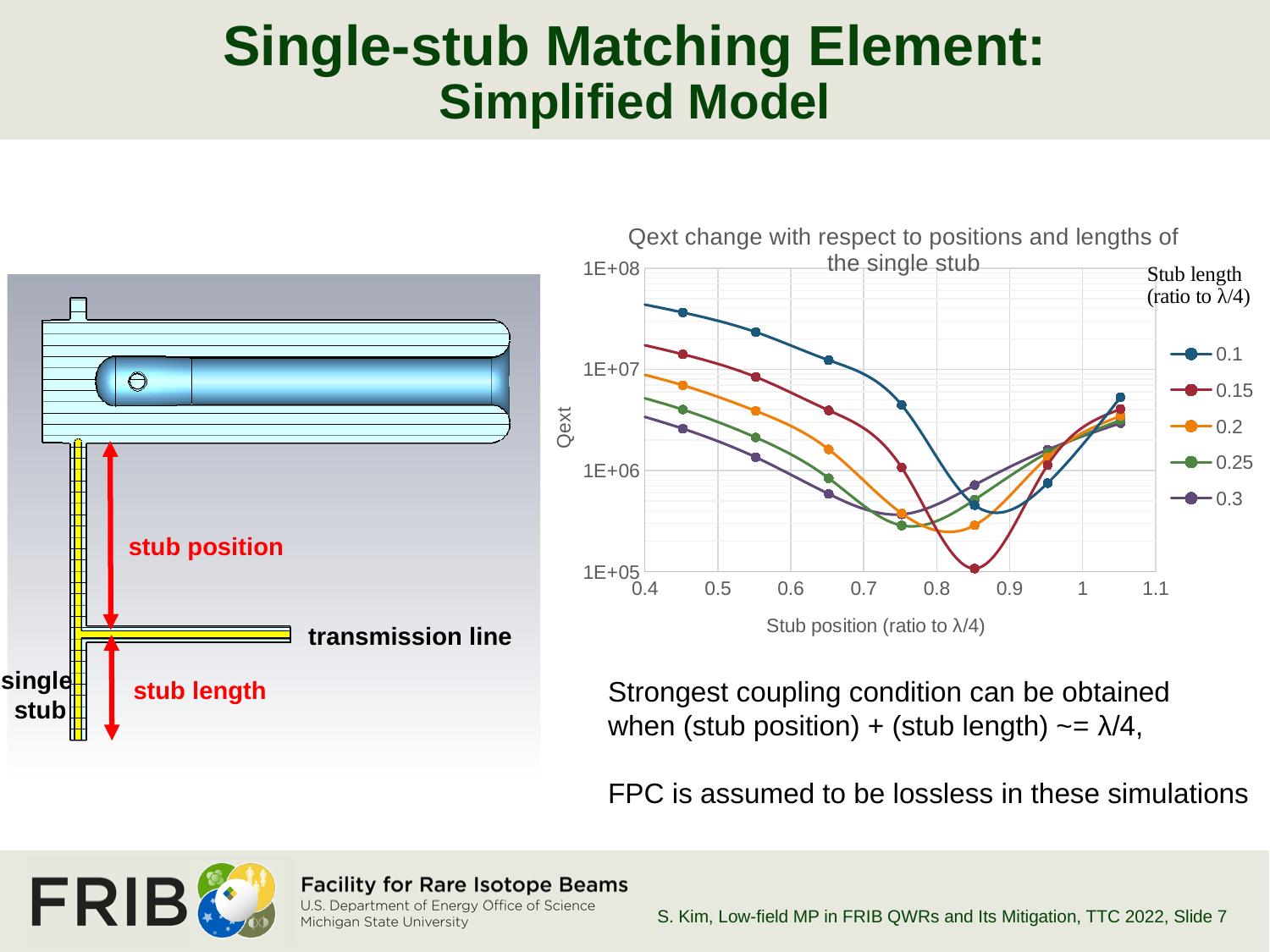
Is the Qext value for the 0.15 series at stub position 0.85 greater or less than 1E+06? less How many data points are plotted for the 0.1 series? 7 Which series reaches the lowest Qext value on the chart? 0.15 What kind of chart is shown on the slide? line chart What is the title of the chart? Qext change with respect to positions and lengths of the single stub Is the Qext value for the 0.3 series at stub position 0.45 greater or less than 1E+06? greater At stub position 0.45, which series has the higher Qext, 0.1 or 0.3? 0.1 What is the label of the x axis of the chart? Stub position (ratio to λ/4) Is the Qext value for the 0.1 series at stub position 0.45 greater or less than 1E+07? greater How many series does the legend of the chart list? 5 Does the Qext of the 0.1 series rise or fall as the stub position increases from 0.45 to 0.85? fall